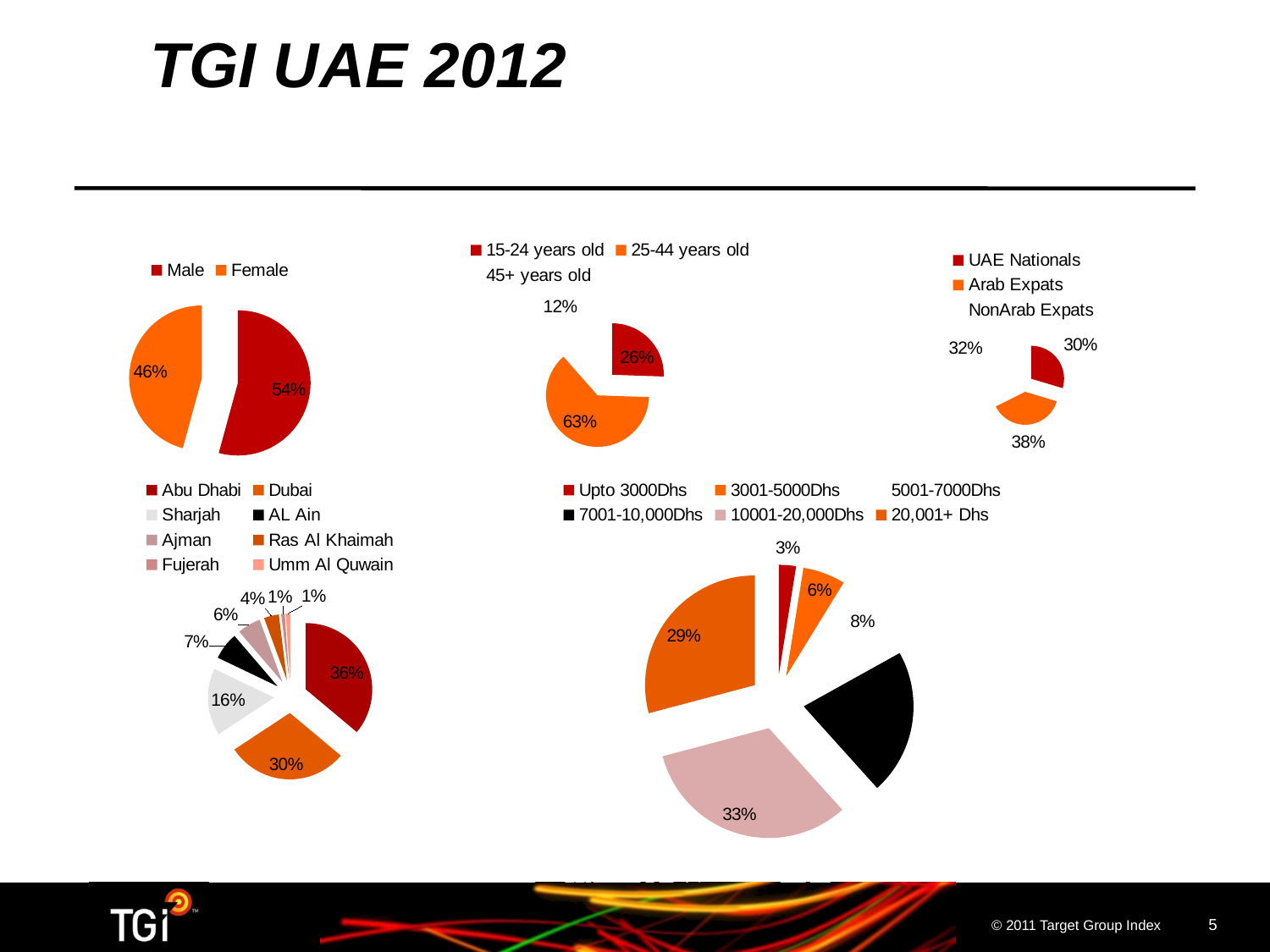
In the income pie chart (bottom right), what share is 10001-20,000Dhs? 33% In the gender pie chart (top left), what percentage is Male? 54% In the emirate pie chart (bottom left), what share is Sharjah? 16% In the age pie chart (top centre), which age group has the smallest share? 45+ years old In the gender pie chart (top left), what is the difference between the Male and Female shares? 8% In the nationality pie chart (top right), which group has the largest share? Arab Expats In the age pie chart (top centre), what share is 25-44 years old? 63% In the emirate pie chart (bottom left), which emirate has the largest share? Abu Dhabi In the income pie chart (bottom right), which is larger: 3001-5000Dhs or 5001-7000Dhs? 5001-7000Dhs What type of chart is used for the gender breakdown on this slide? Pie chart In the nationality pie chart (top right), what share is Arab Expats? 38% In the emirate pie chart (bottom left), how many categories does the legend list? 8